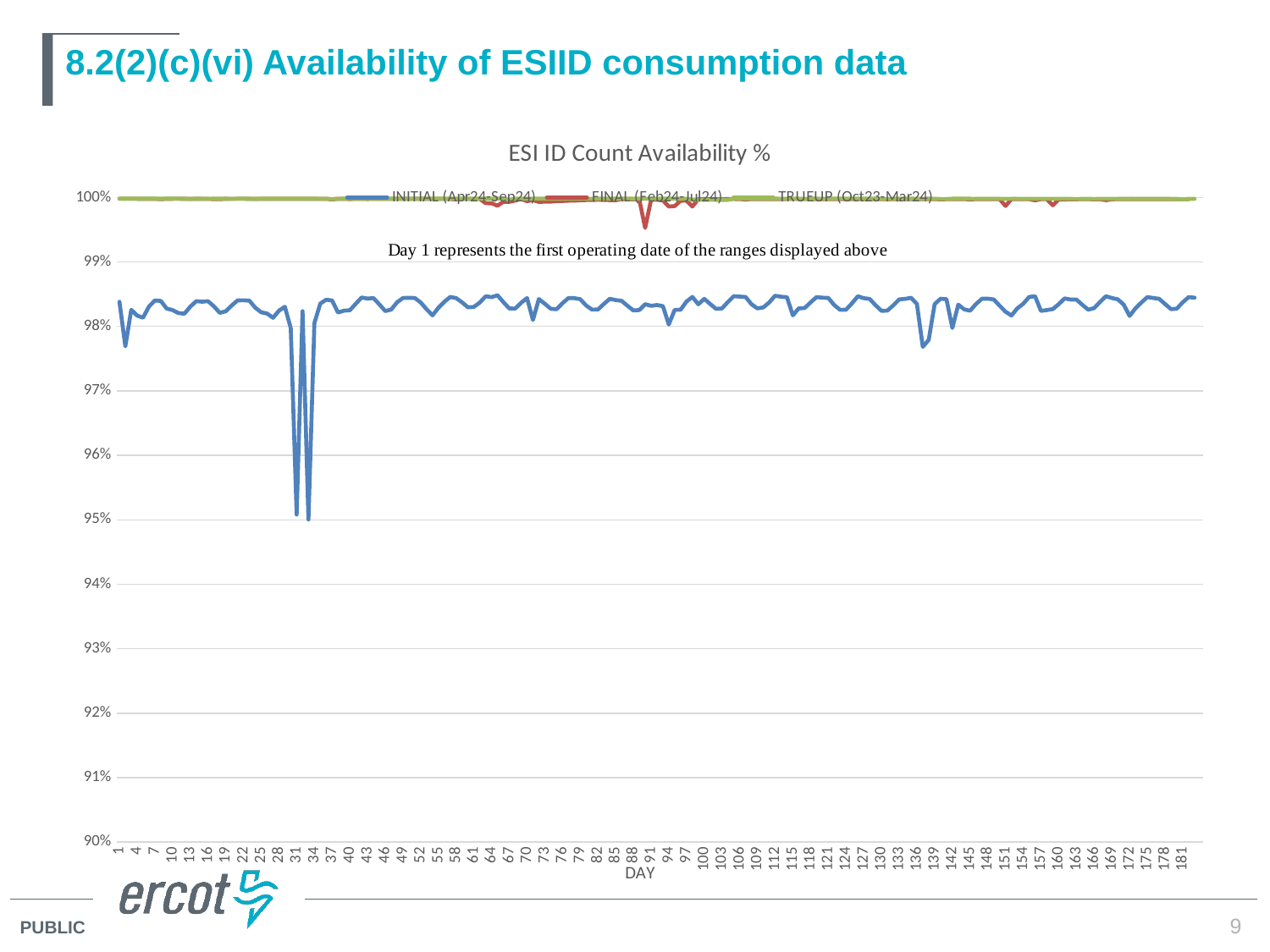
What is the label of the x axis? DAY Is the value of the TRUEUP (Oct23-Mar24) series at day 100 greater or less than 99%? greater What kind of chart is shown on the slide? Line chart How many series does the chart's legend list? 3 Is the value of the INITIAL (Apr24-Sep24) series at day 31 greater or less than 96%? less Is the value of the INITIAL (Apr24-Sep24) series at day 100 greater or less than 98%? greater Which series reaches the lowest value anywhere on the chart? INITIAL (Apr24-Sep24) At day 50, which series is higher: INITIAL (Apr24-Sep24) or TRUEUP (Oct23-Mar24)? TRUEUP (Oct23-Mar24) What is the title of the chart? ESI ID Count Availability %